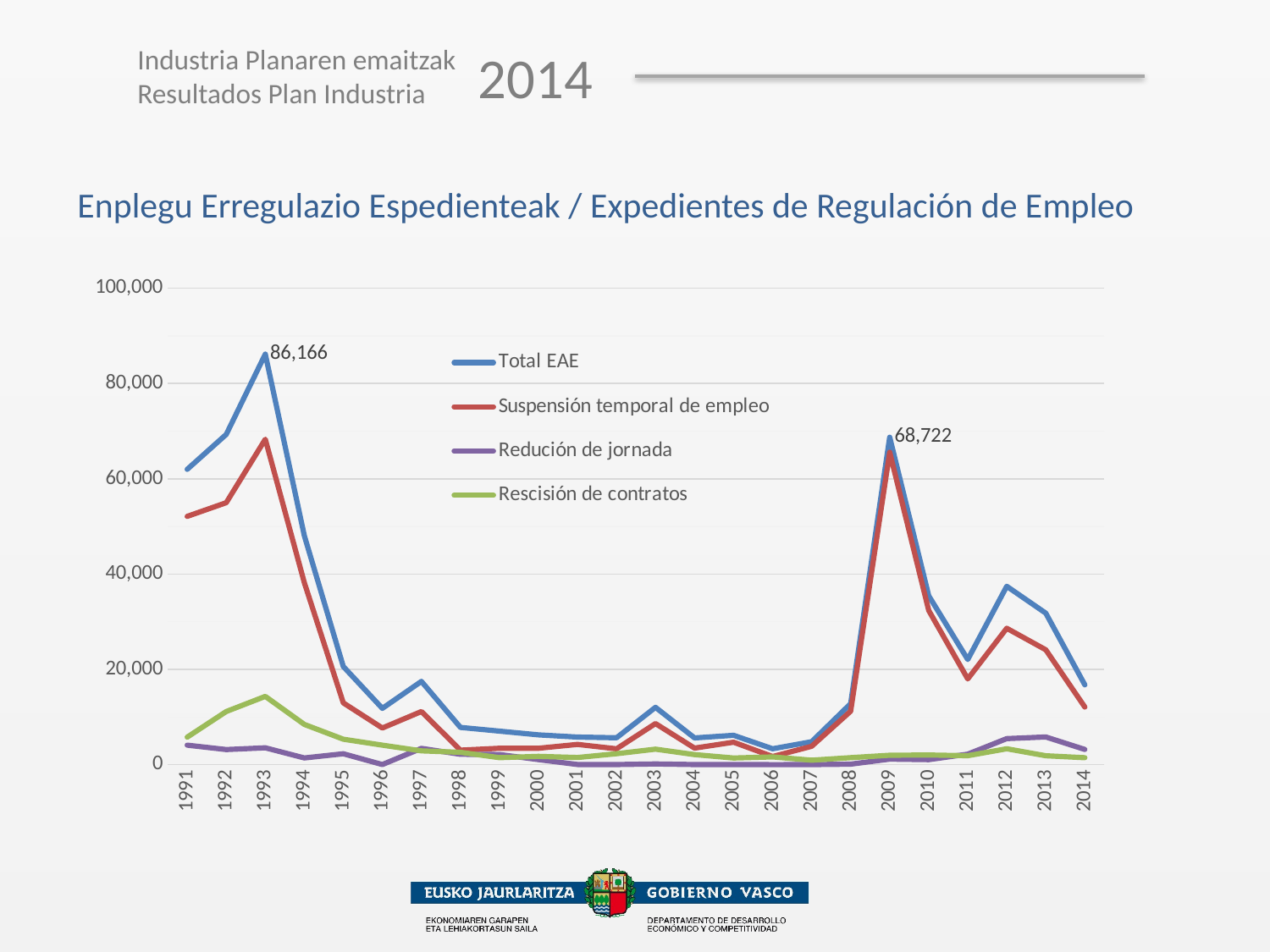
What is the difference between the Total EAE values in 1993 and 2009? 17,444 What kind of chart is shown on the slide? line chart In which year does Total EAE reach its highest value? 1993 How many series does the legend list? 4 What is the value of Total EAE in 1993? 86,166 Which is larger, the Total EAE value in 1993 or in 2009? 1993 What is the value of Total EAE in 2009? 68,722 Is the value for Total EAE in 2014 greater or less than 20,000? less Does the Total EAE line rise or fall from 2009 to 2011? fall Is the value for Total EAE in 1991 greater or less than 40,000? greater How many years are plotted on the x axis? 24 Which series is drawn in green in the legend? Rescisión de contratos